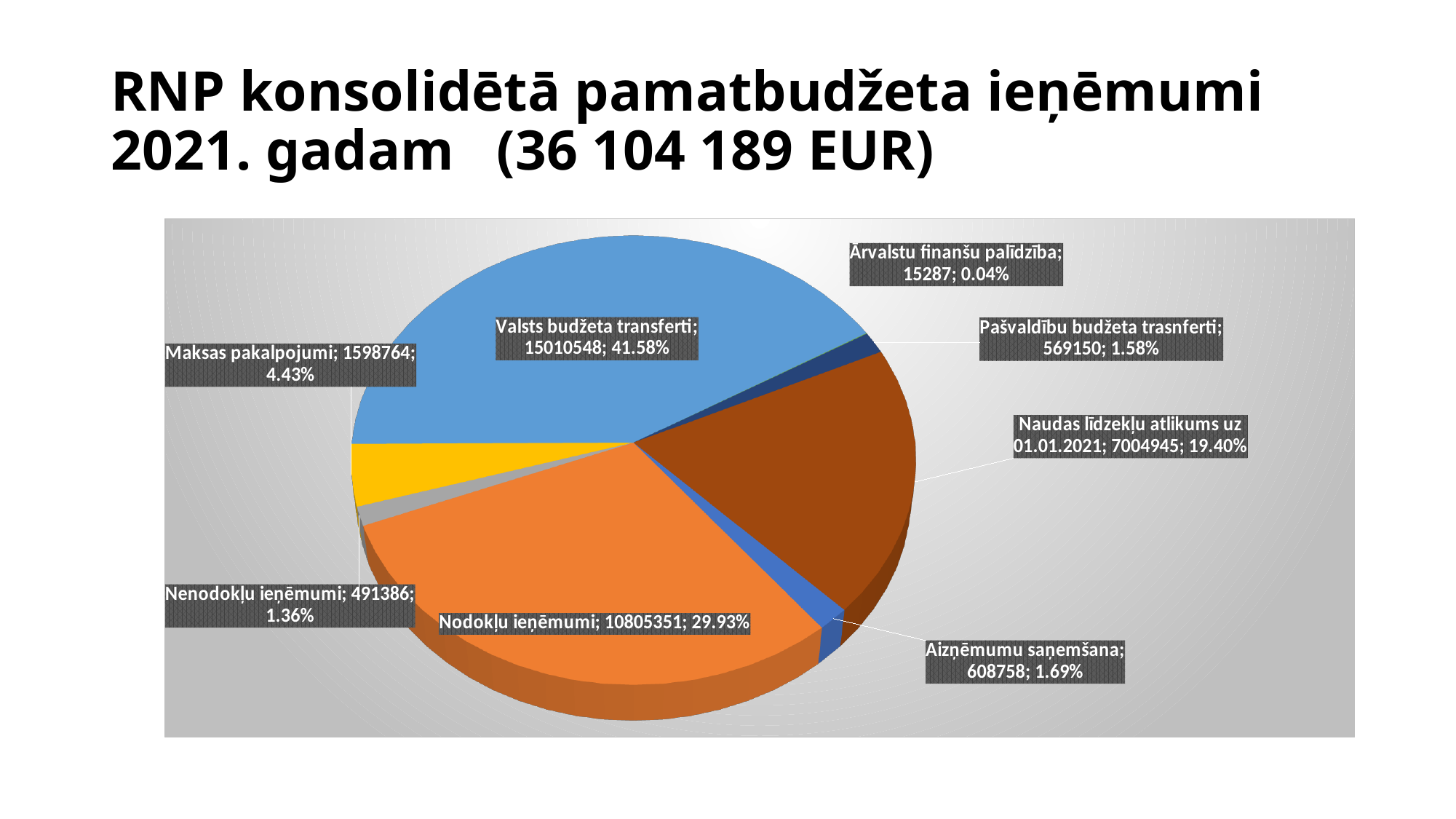
What share of the pie does Aizņēmumu saņemšana represent? 1.69% What is the value for Nodokļu ieņēmumi? 10805351 Which category has the smallest slice? Ārvalstu finanšu palīdzība What is the value for Naudas līdzekļu atlikums uz 01.01.2021? 7004945 Which category has the largest slice? Valsts budžeta transferti How many slices does the pie chart have? 8 What is the value for Valsts budžeta transferti? 15010548 What is the difference between the values for Valsts budžeta transferti and Nodokļu ieņēmumi? 4205197 What kind of chart is shown on the slide? pie chart Which is larger, Pašvaldību budžeta trasnferti or Nenodokļu ieņēmumi? Pašvaldību budžeta trasnferti What share of the pie does Maksas pakalpojumi represent? 4.43% What total amount in EUR is stated in the slide title? 36 104 189 EUR